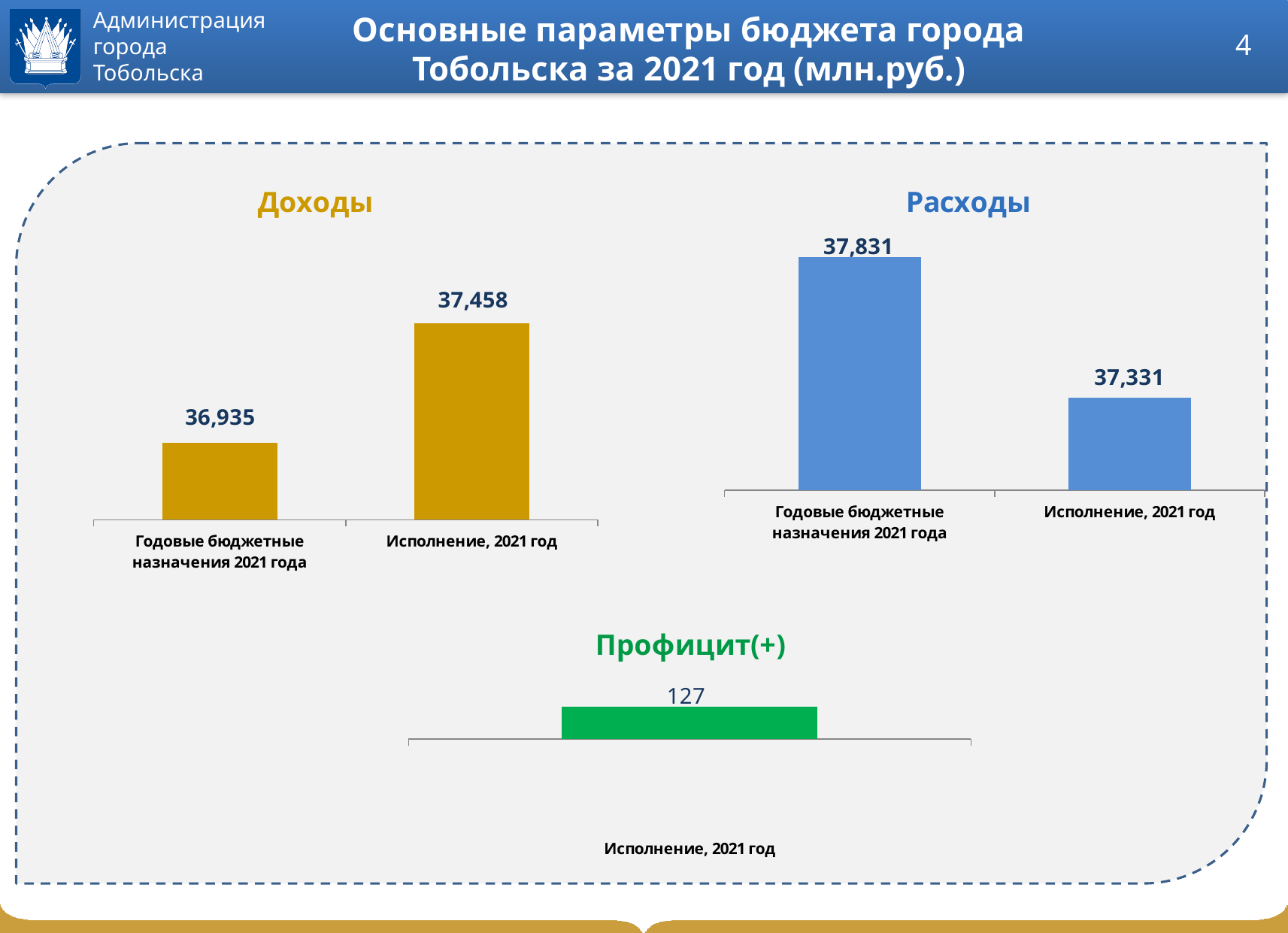
In the Доходы chart, do the values rise or fall from Годовые бюджетные назначения 2021 года to Исполнение, 2021 год? rise What colour are the bars in the Расходы chart? blue What type of chart is the Расходы chart? bar chart In the Расходы chart, what is the value for Годовые бюджетные назначения 2021 года? 37,831 How many bars are in the Доходы chart? 2 In the Расходы chart, which category has the lower value? Исполнение, 2021 год In the Профицит(+) chart, what is the value for Исполнение, 2021 год? 127 In the Расходы chart, what is the value for Исполнение, 2021 год? 37,331 In the Доходы chart, what is the value for Годовые бюджетные назначения 2021 года? 36,935 In the Доходы chart, what is the value for Исполнение, 2021 год? 37,458 In the Доходы chart, which category has the higher value? Исполнение, 2021 год In the Расходы chart, is the value for Годовые бюджетные назначения 2021 года larger or smaller than the value for Исполнение, 2021 год? larger